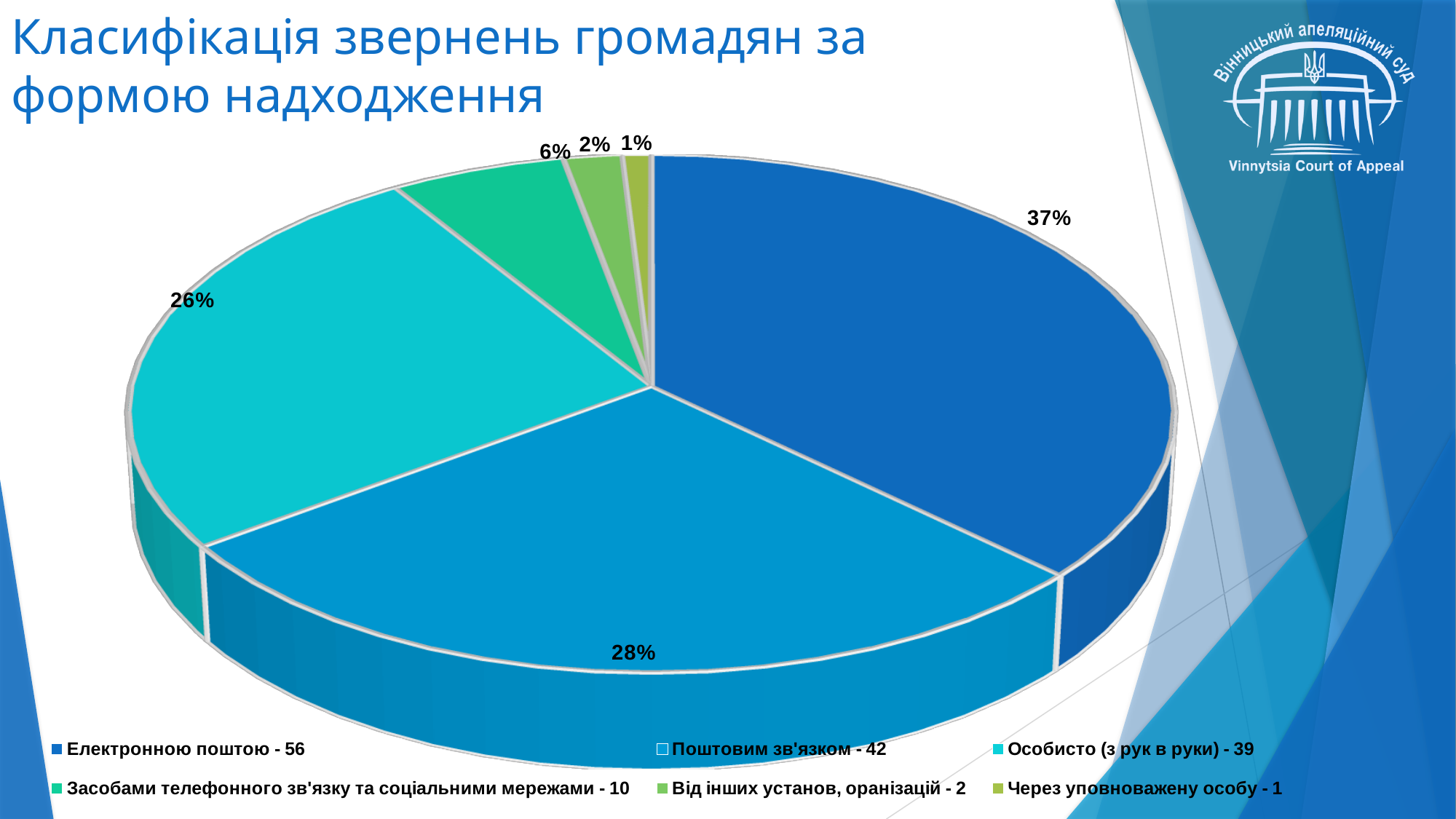
What share of the pie does "Електронною поштою" represent? 37% What share of the pie does "Засобами телефонного зв'язку та соціальними мережами" represent? 6% What share of the pie does "Особисто (з рук в руки)" represent? 26% Which is larger: the "Поштовим зв'язком" slice or the "Особисто (з рук в руки)" slice? Поштовим зв'язком Which category has the largest slice of the pie? Електронною поштою What is the title of the chart on the slide? Класифікація звернень громадян за формою надходження How many categories does the pie chart have? 6 What kind of chart is shown on the slide? pie chart Which category has the smallest slice of the pie? Через уповноважену особу What is the difference in percentage points between the "Електронною поштою" slice and the "Поштовим зв'язком" slice? 9% According to the legend, how many appeals were received "Від інших установ, оранізацій"? 2